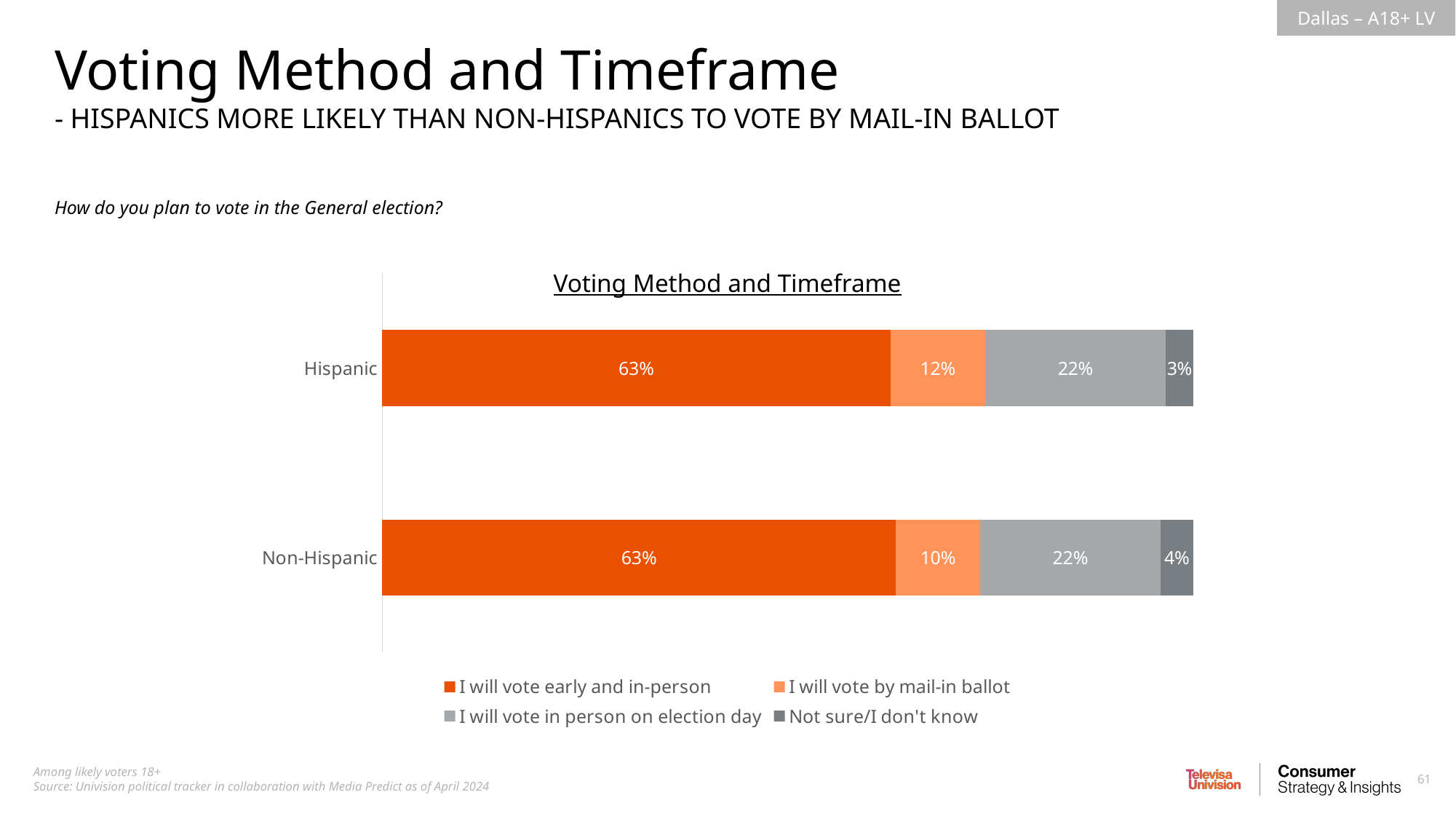
Which response has the lowest share among Non-Hispanic likely voters? Not sure/I don't know What percentage of Non-Hispanic likely voters say they will vote early and in-person? 63% What percentage of Hispanic likely voters say they will vote by mail-in ballot? 12% What is the total of the Hispanic bar's segments? 100% What percentage of Hispanic likely voters say they will vote in person on election day? 22% What is the difference in percentage points between Hispanic and Non-Hispanic likely voters who will vote by mail-in ballot? 2 Which voting method has the highest share among Hispanic likely voters? I will vote early and in-person How many series does the legend list? 4 What percentage of Non-Hispanic likely voters answered 'Not sure/I don't know'? 4% How many groups (bars) are shown in the chart? 2 Which group has a larger share saying they will vote by mail-in ballot, Hispanic or Non-Hispanic? Hispanic What kind of chart is shown on the slide? Stacked bar chart